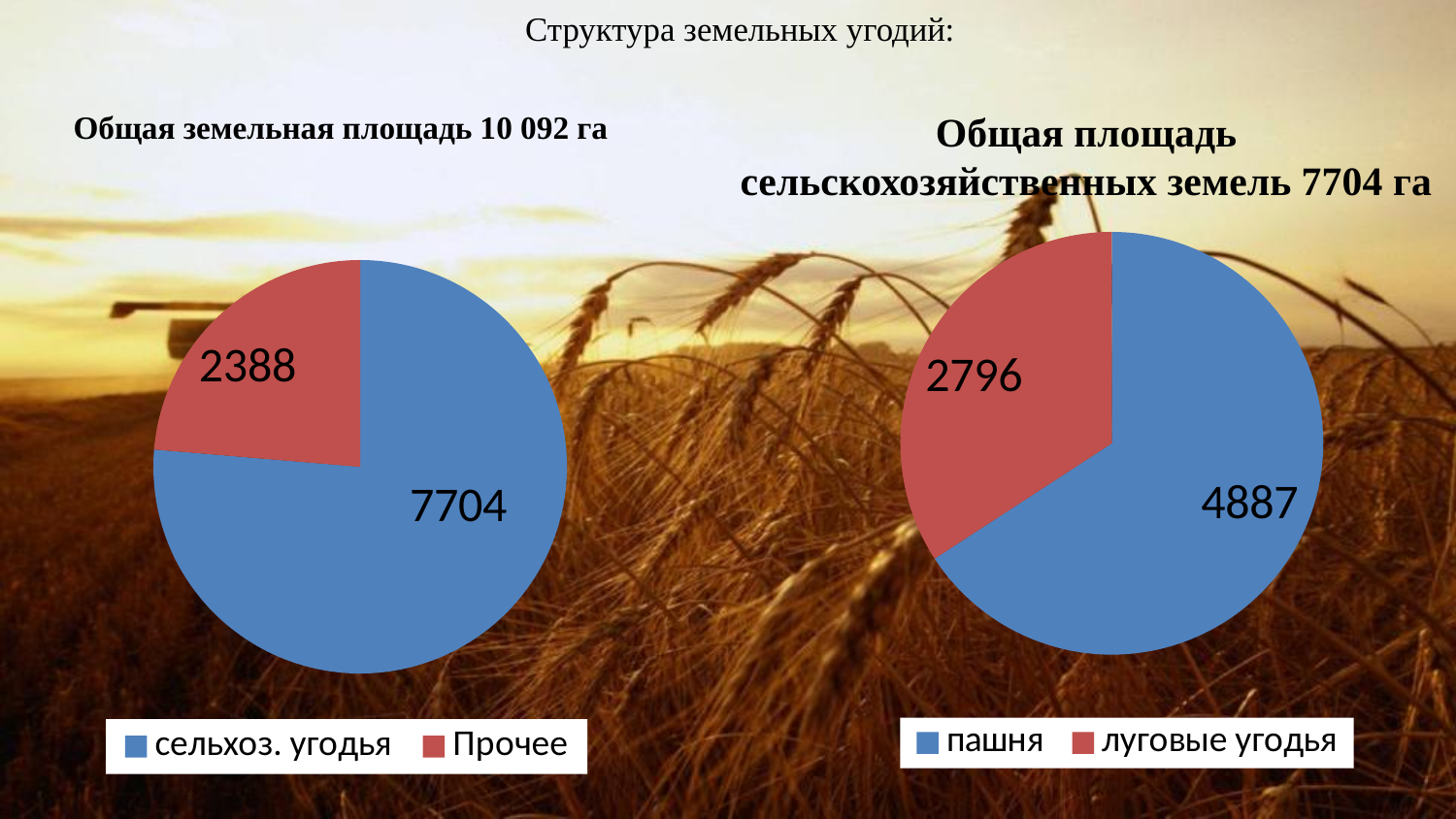
In the right pie chart, which category has the smallest slice? луговые угодья What type of chart is used on the right side of the slide? pie chart In the right pie chart, which is larger: пашня or луговые угодья? пашня In the right pie chart, what is the difference between пашня and луговые угодья? 2091 In the left pie chart (Общая земельная площадь 10 092 га), what is the value for сельхоз. угодья? 7704 In the right pie chart, what colour is the slice for луговые угодья? red In the left pie chart, which category has the largest slice? сельхоз. угодья In the left pie chart (Общая земельная площадь 10 092 га), what is the value for Прочее? 2388 In the right pie chart (Общая площадь сельскохозяйственных земель 7704 га), what is the value for луговые угодья? 2796 In the left pie chart, what is the difference between сельхоз. угодья and Прочее? 5316 How many slices does the left pie chart have? 2 In the right pie chart (Общая площадь сельскохозяйственных земель 7704 га), what is the value for пашня? 4887